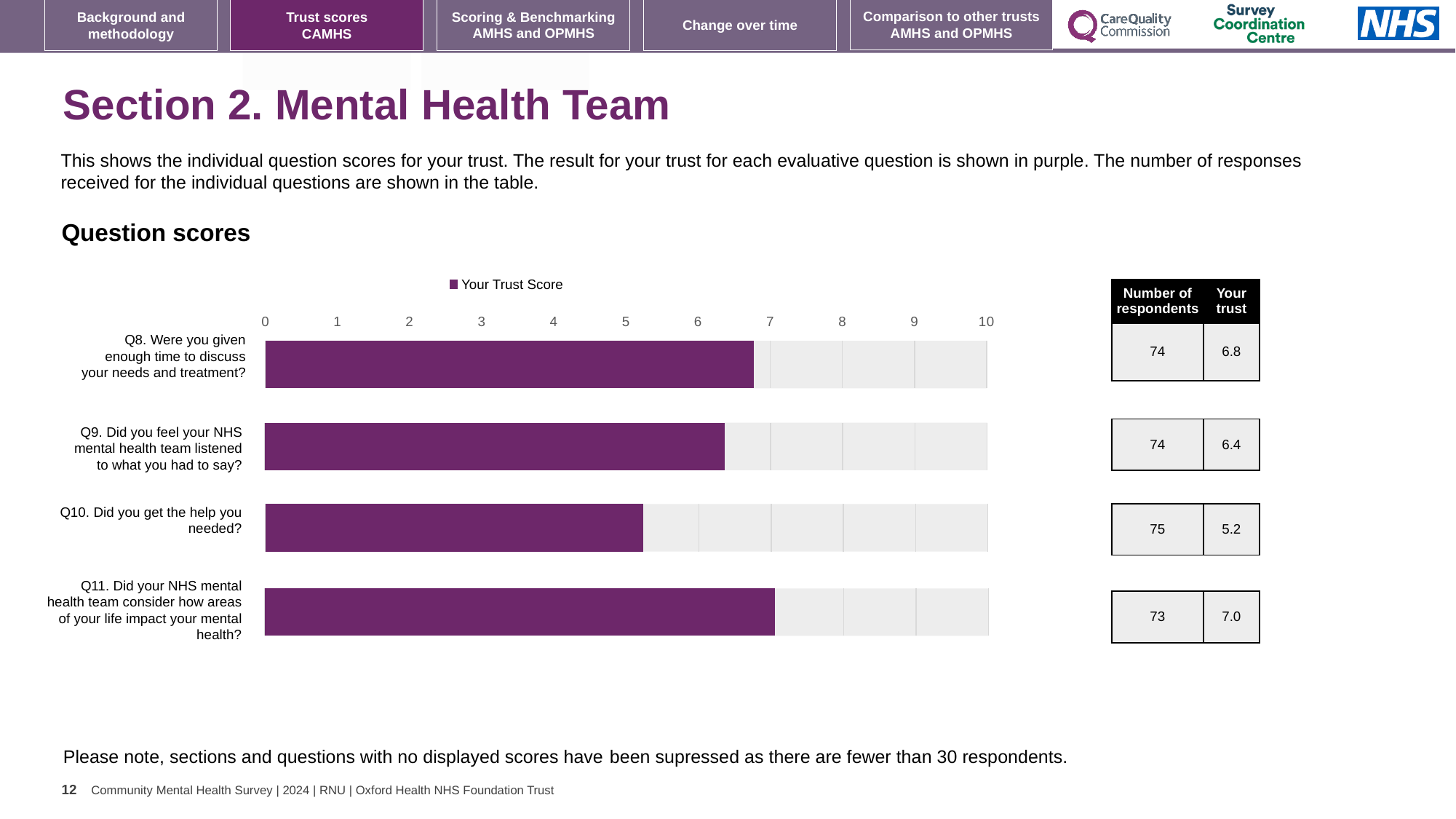
Which has a higher Your Trust Score, Q9 or Q10? Q9 What is the Your Trust Score for Q10 (Did you get the help you needed?)? 5.2 What is the Your Trust Score for Q11 (Did your NHS mental health team consider how areas of your life impact your mental health?)? 7.0 What is the name of the series shown in the chart legend? Your Trust Score Which question has the highest Your Trust Score? Q11 Which question has the lowest Your Trust Score? Q10 What kind of chart is used to show the question scores? Bar chart What is the difference between the Your Trust Score for Q8 and Q9? 0.4 Is the value for Q10 greater or less than 6? less How many questions are plotted in the Question scores chart? 4 What is the Your Trust Score for Q8 (Were you given enough time to discuss your needs and treatment?)? 6.8 How many series does the legend of the Question scores chart list? 1